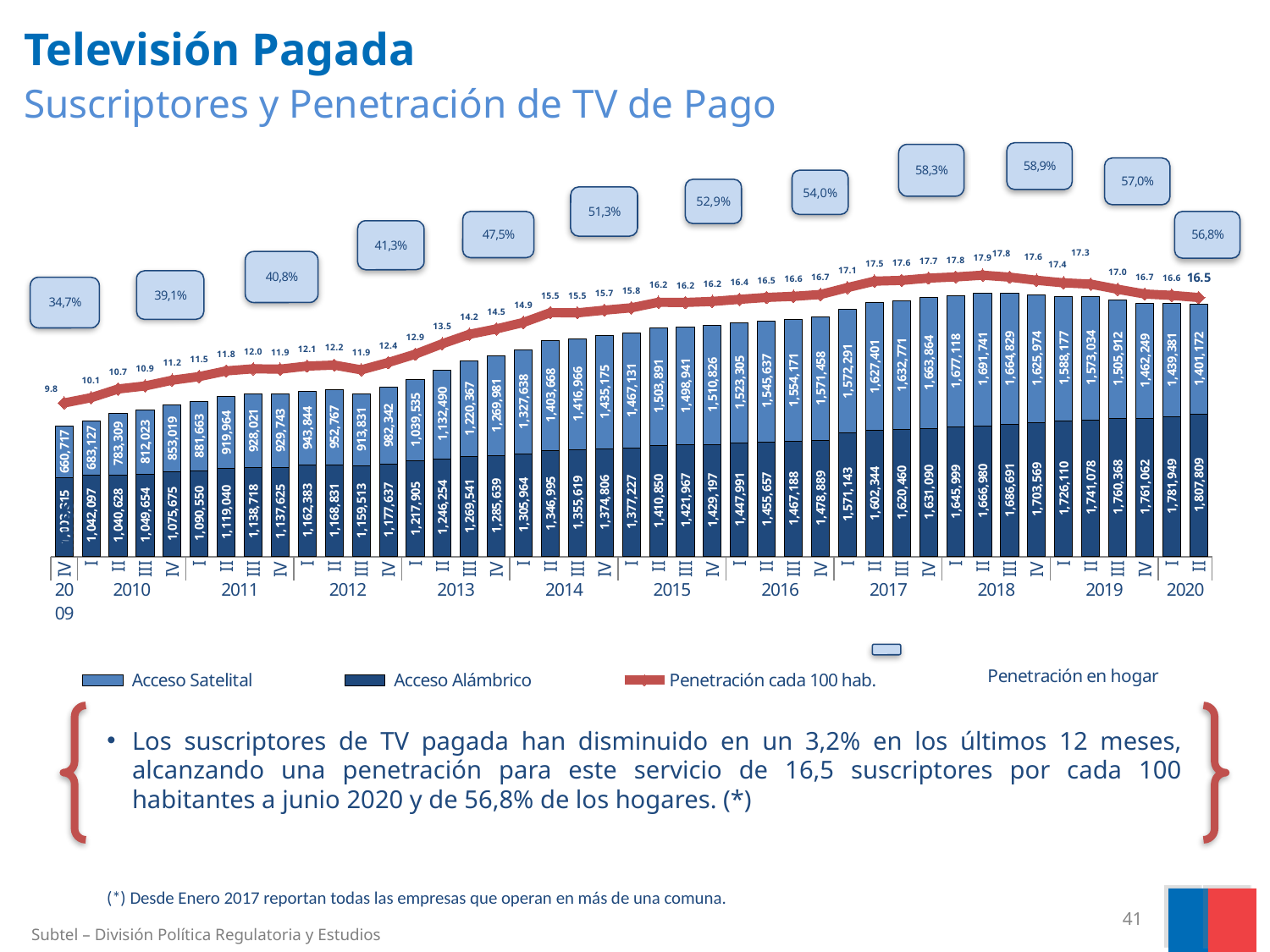
What is the highest value reached by the Penetración cada 100 hab. line? 17.9 What is the Penetración en hogar value shown for 2018? 58,9% In which quarter does Acceso Satelital reach its highest value? II 2018 (1,691,741) Does the Acceso Alámbrico series rise or fall from IV 2009 to II 2020? rise What is the Acceso Alámbrico value for II 2020? 1,807,809 In II 2020, which is larger: Acceso Satelital or Acceso Alámbrico? Acceso Alámbrico What is the Acceso Satelital value for II 2020? 1,401,172 What kind of chart is shown on the slide? stacked bar chart with a line What is the difference between the Acceso Alámbrico values for II 2020 and I 2020? 25,860 What is the Penetración cada 100 hab. value for II 2020? 16.5 What is the Penetración en hogar value shown for 2009? 34,7% What is the total of the stacked bar for II 2020 (Acceso Satelital plus Acceso Alámbrico)? 3,208,981